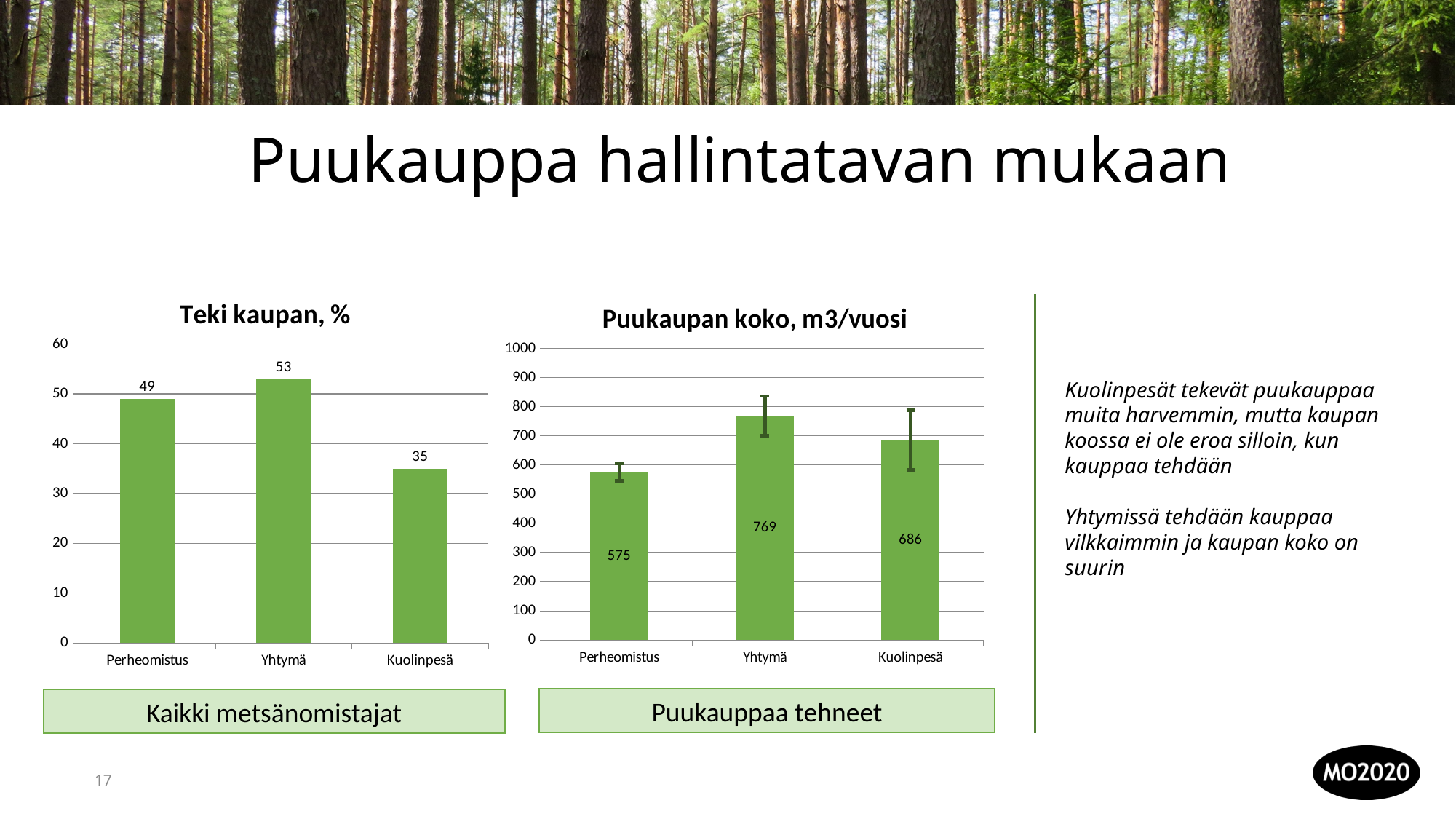
In the 'Puukaupan koko, m3/vuosi' chart, what is the value for Perheomistus? 575 In the 'Teki kaupan, %' chart, which category has the lowest value? Kuolinpesä In the 'Teki kaupan, %' chart, what is the difference between Yhtymä and Kuolinpesä? 18 In the 'Teki kaupan, %' chart, what is the value for Yhtymä? 53 In the 'Puukaupan koko, m3/vuosi' chart, which category has the highest value? Yhtymä In the 'Puukaupan koko, m3/vuosi' chart, which is larger, Perheomistus or Kuolinpesä? Kuolinpesä In the 'Teki kaupan, %' chart, how many categories are shown? 3 What label appears in the box below the 'Puukaupan koko, m3/vuosi' chart? Puukauppaa tehneet What kind of chart is the 'Teki kaupan, %' chart? bar chart In the 'Teki kaupan, %' chart, what is the value for Perheomistus? 49 In the 'Puukaupan koko, m3/vuosi' chart, is the value for Yhtymä greater or less than 700? greater In the 'Puukaupan koko, m3/vuosi' chart, what is the difference between Yhtymä and Kuolinpesä? 83